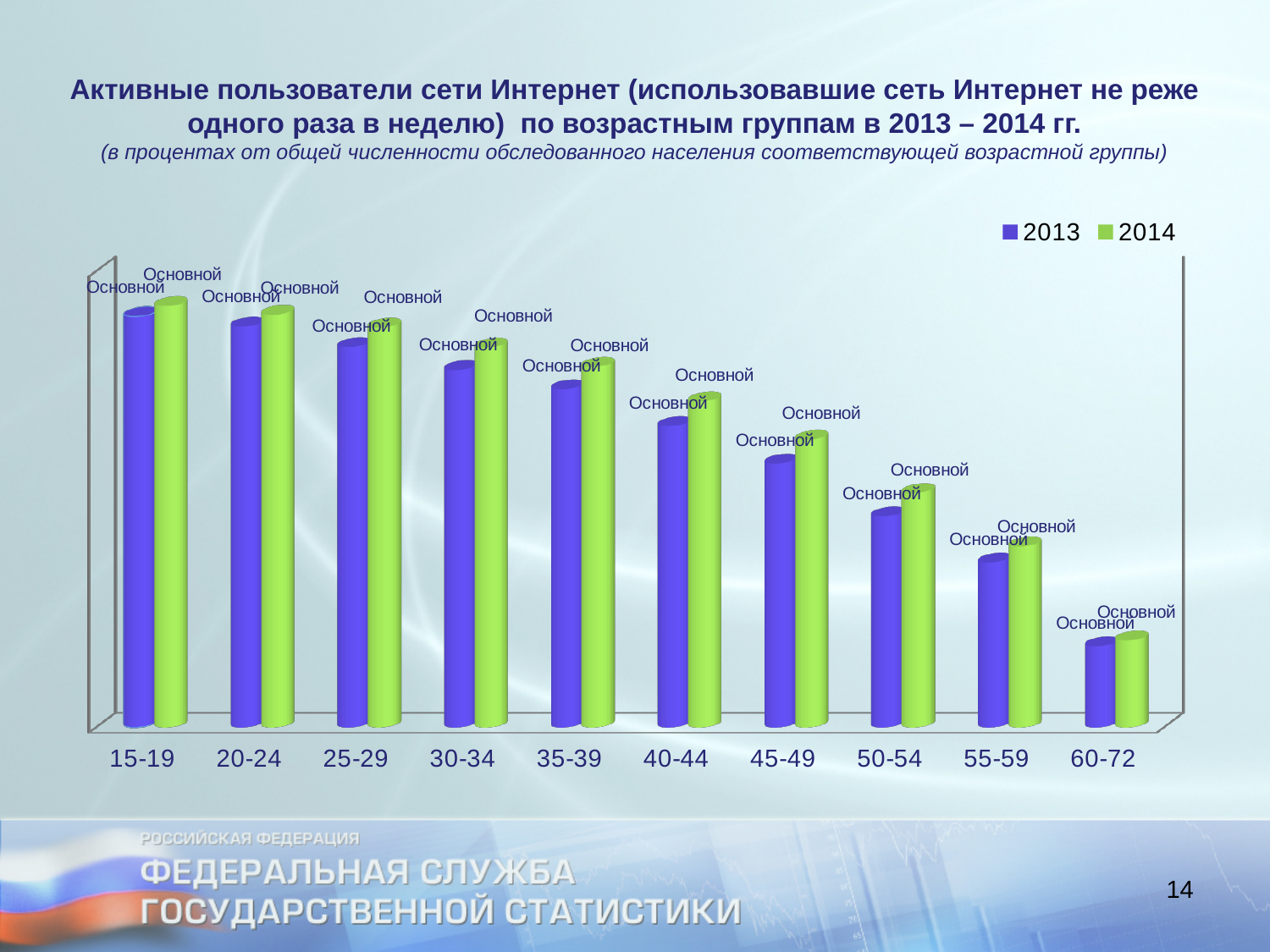
How many age groups are shown on the x axis of the chart? 10 For the 40-44 age group, which is larger: the 2013 value or the 2014 value? 2014 Which age group has the lowest value for 2013? 60-72 For the 55-59 age group, which is larger: the 2013 value or the 2014 value? 2014 Which series are listed in the chart's legend? 2013 and 2014 Which is larger for 2013: the value for 25-29 or the value for 50-54? 25-29 Which colour represents the 2014 series in the chart? green How many series does the chart's legend list? 2 What kind of chart is shown on the slide? bar chart Which age group has the lowest value for 2014? 60-72 Which age group has the highest value for 2014? 15-19 Do the values for 2013 rise or fall as the age groups move from 15-19 to 60-72? fall